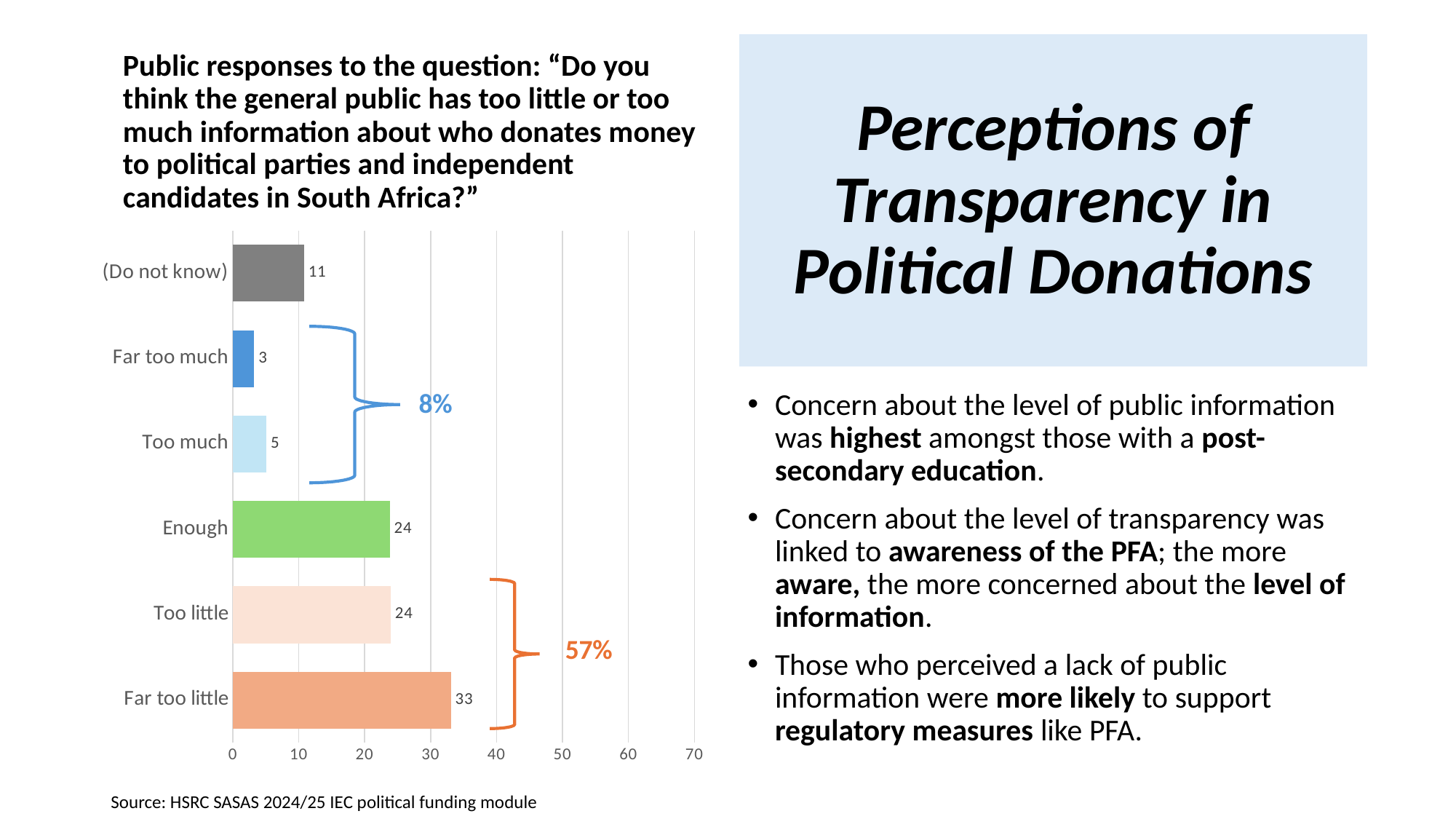
Is the value for "Far too little" greater or less than 30? greater What is the value for "Far too much"? 3 What is the value for "(Do not know)"? 11 Which category has the lowest value? Far too much Which category has the highest value? Far too little What percentage is shown next to the bracket grouping "Too little" and "Far too little"? 57% What is the value for "Far too little"? 33 What is the value for "Enough"? 24 What kind of chart is shown on the slide? bar chart Which is larger, the value for "Too much" or the value for "(Do not know)"? (Do not know) How many categories are shown in the chart? 6 What is the difference between the values for "Far too little" and "Too little"? 9